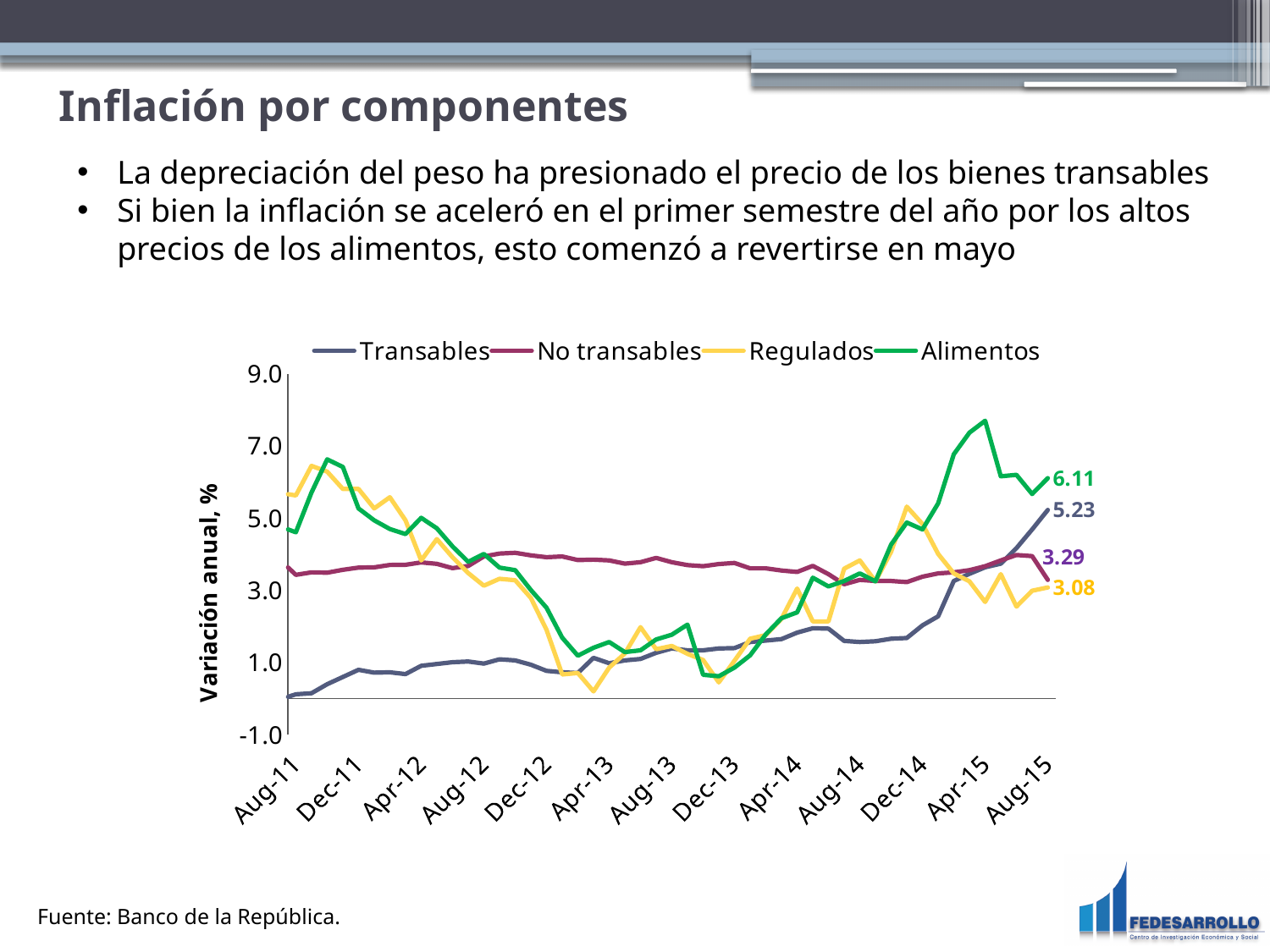
Does the Transables series rise or fall between Dec-13 and Aug-15? rise What is the difference between the Aug-15 labelled values of Alimentos and Transables? 0.88 At Aug-15, which is larger: the labelled value for No transables or for Regulados? No transables What is the final labelled value for Transables at Aug-15? 5.23 How many series does the legend list? 4 Which series has the highest labelled value at Aug-15? Alimentos Which series has the lowest labelled value at Aug-15? Regulados What is the final labelled value for No transables at Aug-15? 3.29 What is the final labelled value for Regulados at Aug-15? 3.08 What is the final labelled value for Alimentos at Aug-15? 6.11 What kind of chart is shown on the slide? line chart Is the value for Transables at Aug-11 greater or less than 1.0? less